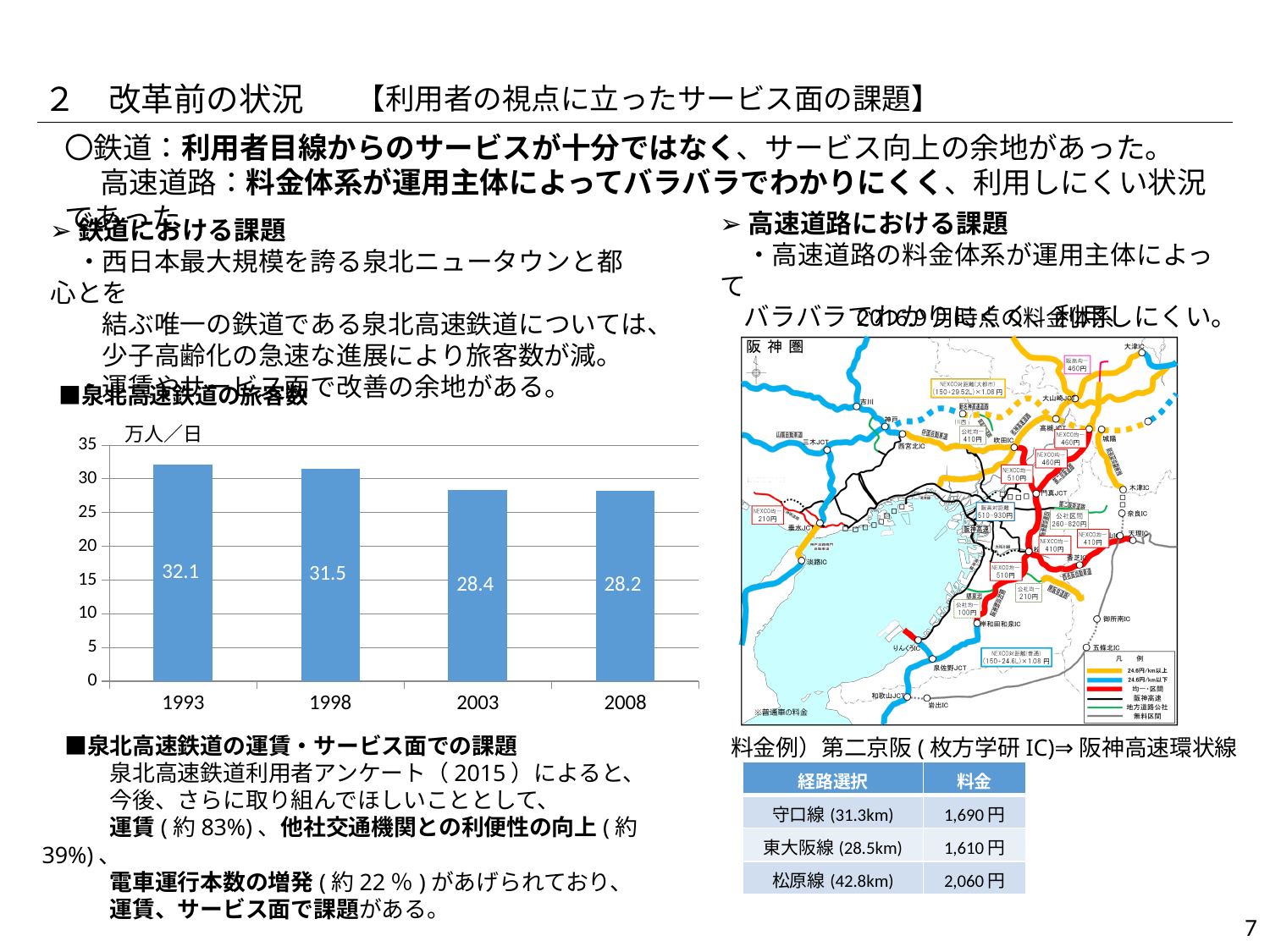
Do the values in the bar chart rise or fall from 1993 to 2008? fall What is the value for 2008 in the bar chart? 28.2 What is the value for 2003 in the bar chart? 28.4 Is the value for 1998 in the bar chart greater or less than 30? greater What is the difference between the values for 1998 and 2003 in the bar chart? 3.1 Which is larger in the bar chart, the value for 1998 or the value for 2003? 1998 How many years are shown on the x axis of the bar chart? 4 Which year has the lowest value in the bar chart? 2008 What is the difference between the values for 1993 and 2008 in the bar chart? 3.9 What is the value for 1993 in the bar chart? 32.1 Which year has the highest value in the bar chart? 1993 What kind of chart is used to show the passenger numbers? bar chart